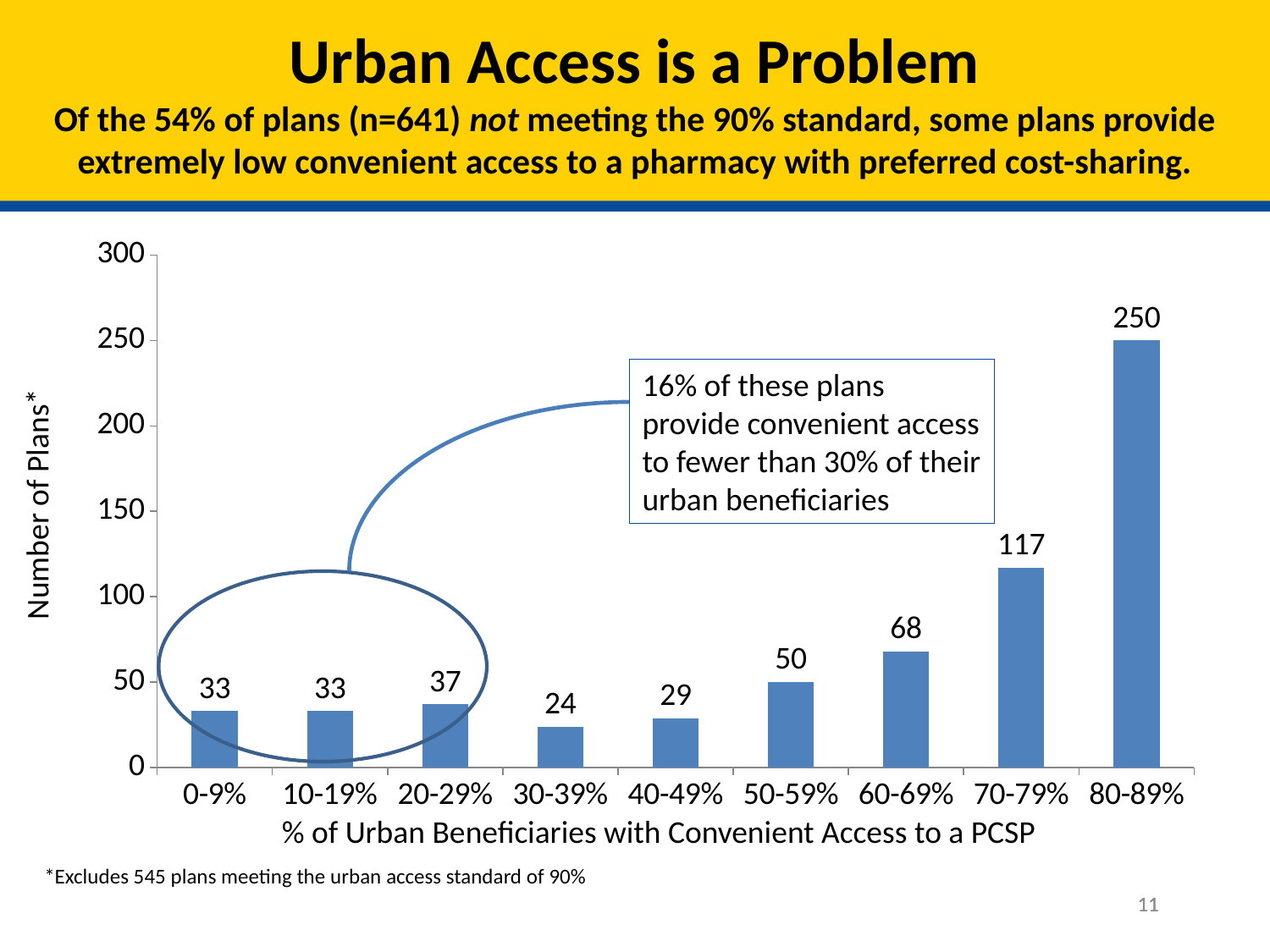
What is the difference in number of plans between the 80-89% and 70-79% categories? 133 How many categories are shown on the x axis? 9 Which category has the lowest number of plans? 30-39% Which category has the highest number of plans? 80-89% How many plans are in the 80-89% category? 250 What is the number of plans for the 30-39% category? 24 What is the label of the y axis? Number of Plans* What is the value for the 70-79% category? 117 Do the values generally rise or fall from the 30-39% category to the 80-89% category? Rise What kind of chart is shown on the slide? Bar chart What is the total number of plans in the 0-9%, 10-19% and 20-29% categories combined? 103 Which has more plans, the 50-59% category or the 40-49% category? 50-59%